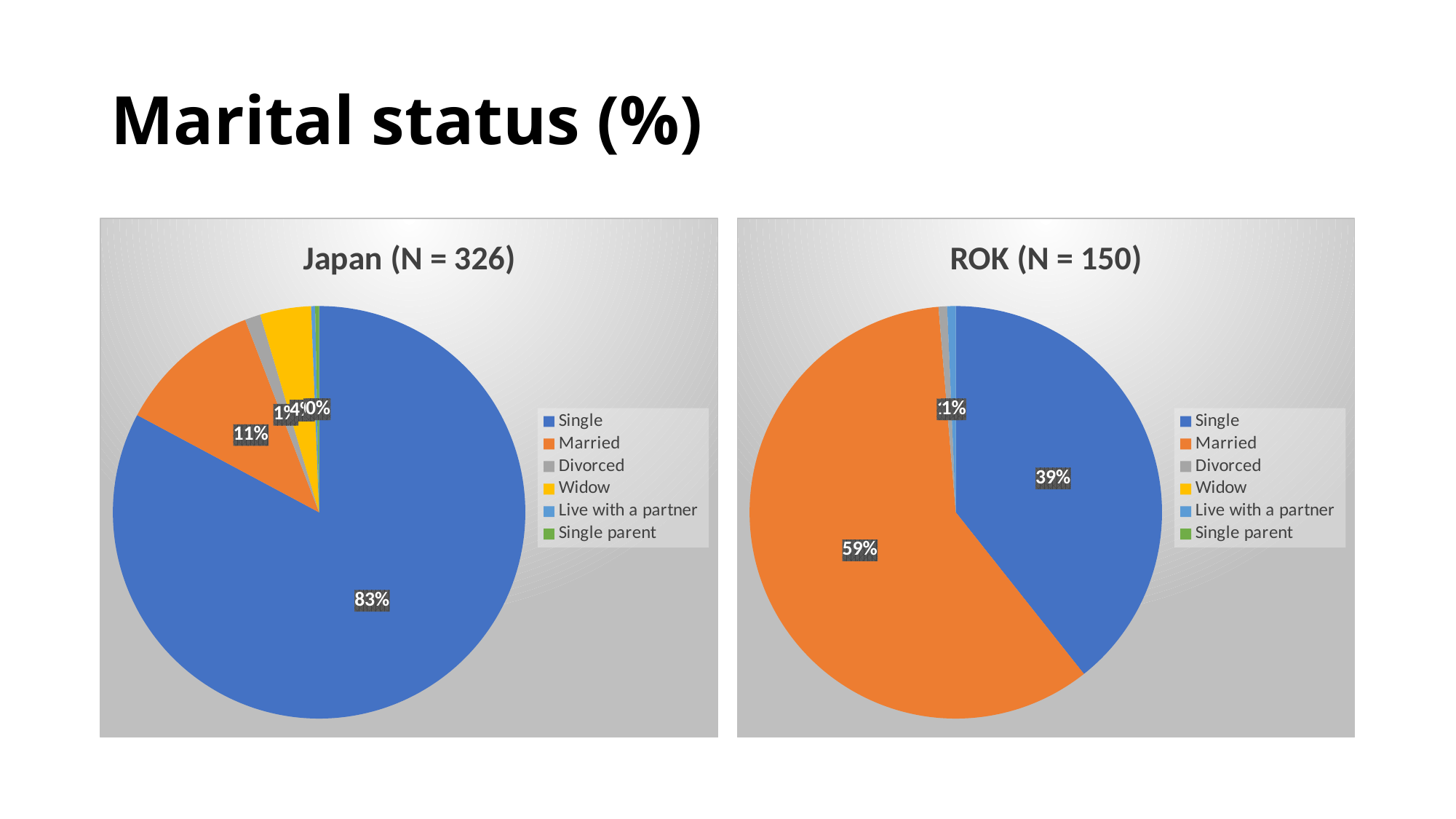
What type of chart is used for the Japan (N = 326) data? Pie chart In the ROK (N = 150) chart, what percentage is labelled for the Single slice? 39% In the ROK (N = 150) chart, what percentage is labelled for the Married slice? 59% In the ROK (N = 150) chart, which category has the largest slice? Married In the Japan (N = 326) chart, what is the difference in percentage points between the Single and Married slices? 72 In the ROK (N = 150) chart, which is larger, the Single slice or the Married slice? Married In the ROK (N = 150) chart, what is the difference in percentage points between the Married and Single slices? 20 What is the title of the slide? Marital status (%) In the Japan (N = 326) chart, what percentage is labelled for the Single slice? 83% How many categories does the legend of the ROK (N = 150) chart list? 6 In the Japan (N = 326) chart, what percentage is labelled for the Married slice? 11% In the Japan (N = 326) chart, which category has the largest slice? Single